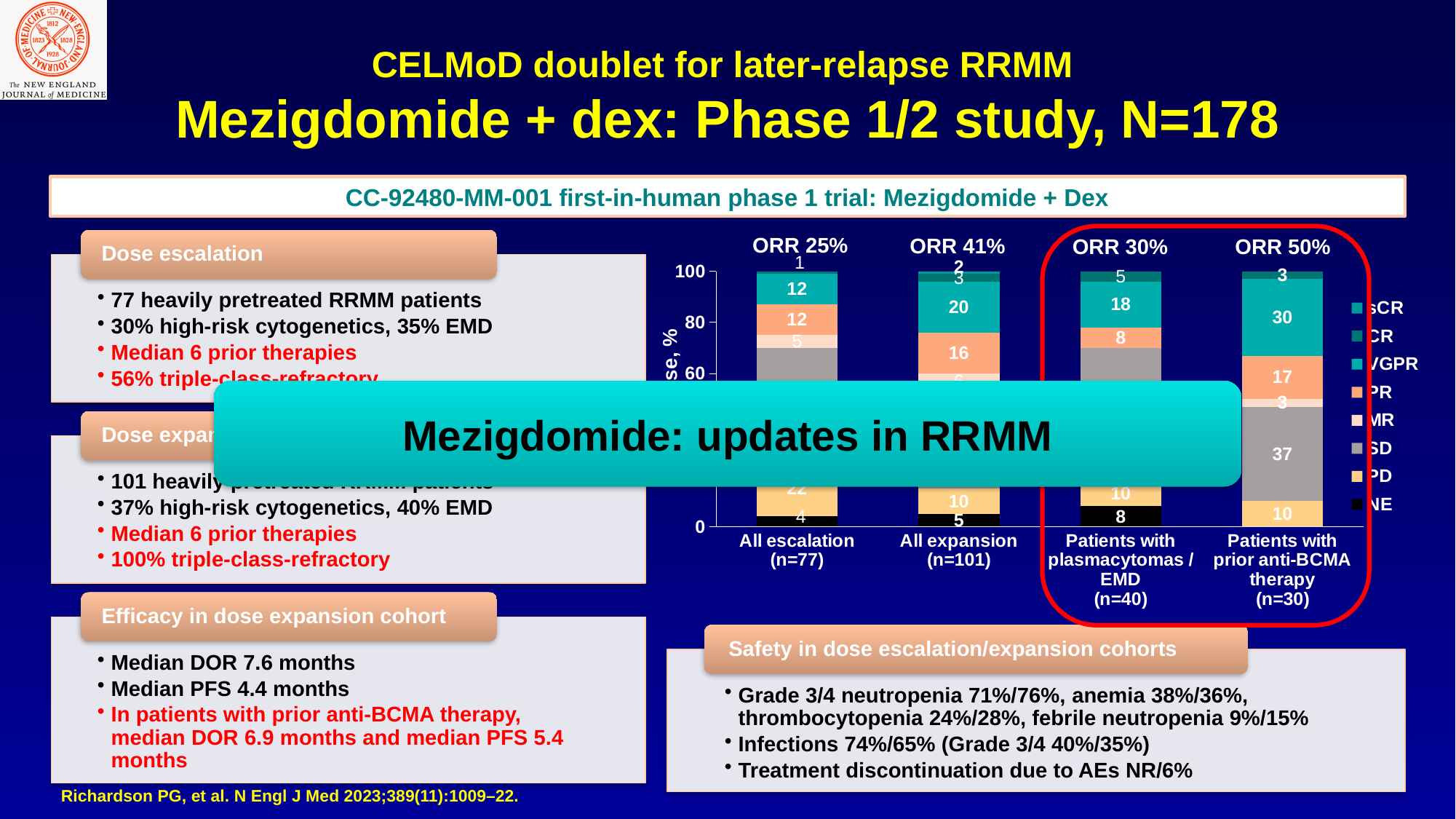
What type of chart is shown on the slide? Stacked bar chart What is the VGPR percentage for patients with prior anti-BCMA therapy? 30 How many response categories does the chart legend list? 8 What is the SD percentage for patients with prior anti-BCMA therapy? 37 How many patient groups (bars) are shown in the chart? 4 What is the ORR shown above the 'Patients with prior anti-BCMA therapy (n=30)' bar? 50% Which patient group has the lowest ORR in the chart? All escalation (n=77) What is the ORR shown above the 'All escalation (n=77)' bar? 25% What is the difference in ORR between the 'All expansion' and 'All escalation' groups? 16% Which patient group has the highest ORR in the chart? Patients with prior anti-BCMA therapy (n=30) What is the ORR shown above the 'All expansion (n=101)' bar? 41% Which is larger: the VGPR value for patients with plasmacytomas/EMD or for all expansion patients? All expansion (20)